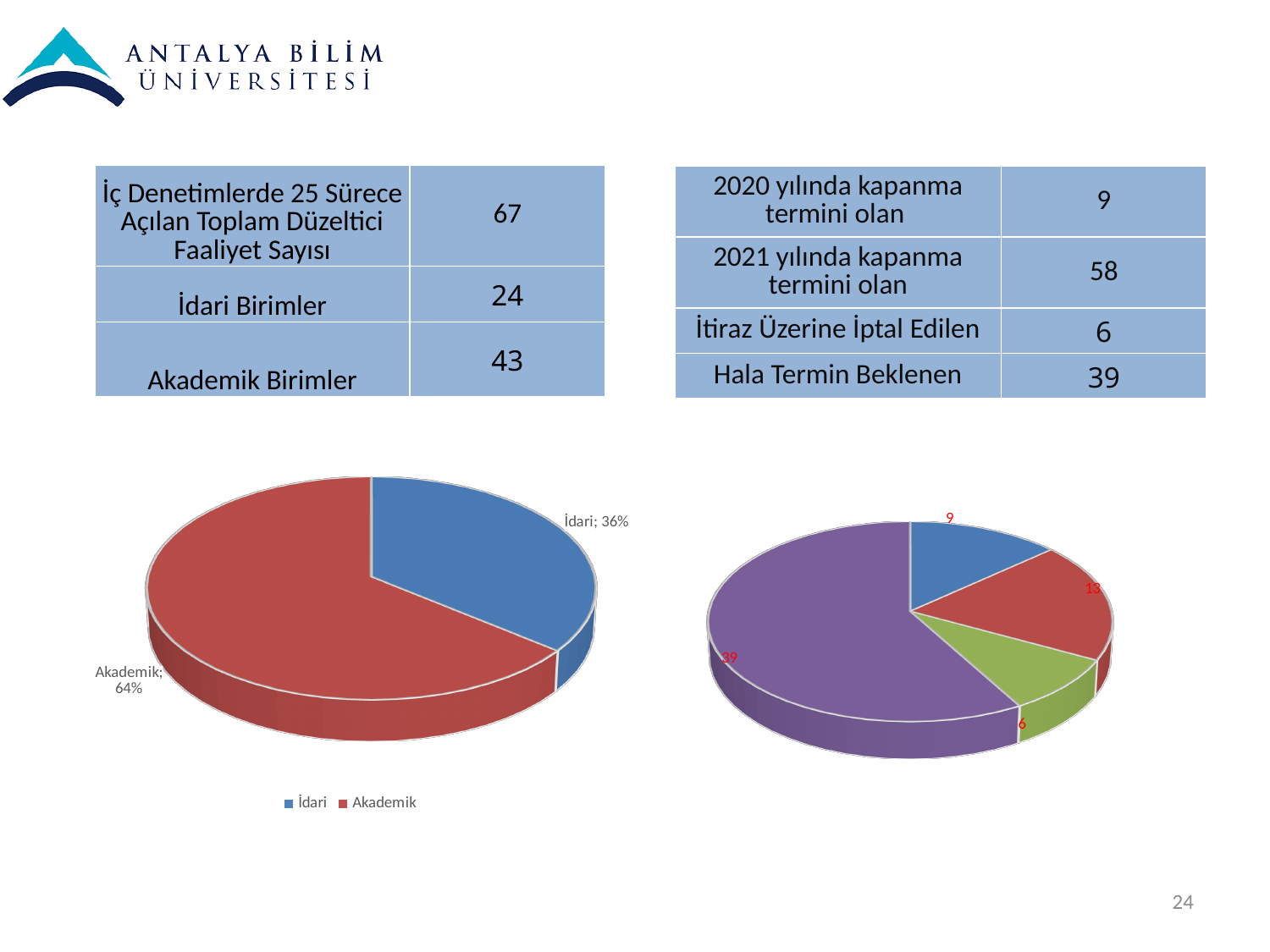
In the left pie chart, what is the difference in percentage points between the Akademik and İdari shares? 28 percentage points In the left pie chart, which slice is larger, İdari or Akademik? Akademik What kind of chart is the chart on the left of the slide? pie chart How many entries does the legend of the left pie chart list? 2 In the right pie chart, what is the smallest data label value shown? 6 In the left pie chart, what colour is the Akademik slice? red How many slices does the left pie chart have? 2 What kind of chart is the chart on the right of the slide? pie chart How many slices does the right pie chart have? 4 In the left pie chart, what share does Akademik have? 64% In the left pie chart, what share does İdari have? 36% In the right pie chart, what is the largest data label value shown? 39